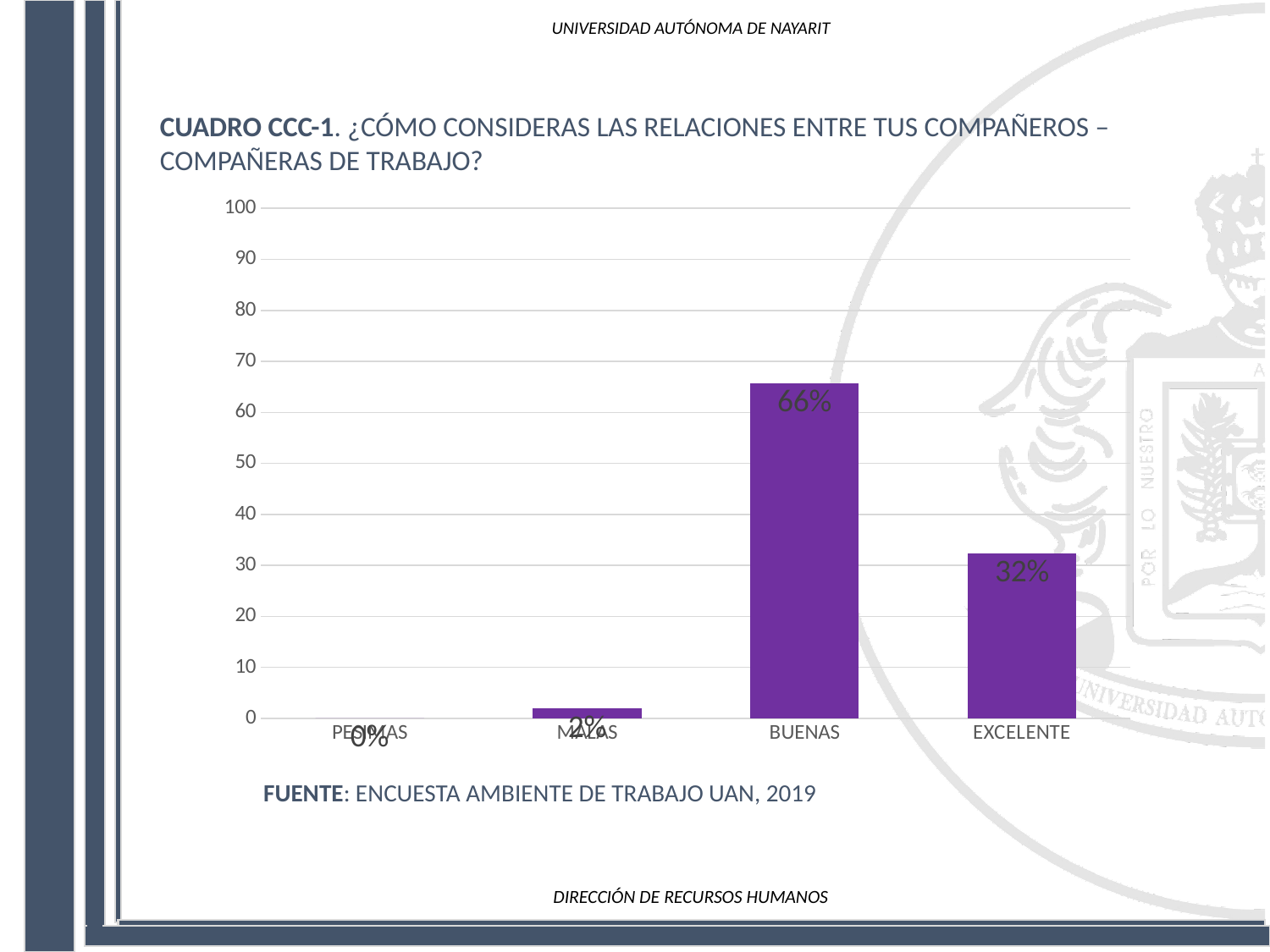
What is the value for PÉSIMAS? 0% What kind of chart is shown on the slide? bar chart What is the value for BUENAS? 66% What is the difference between the values for BUENAS and EXCELENTE? 34% Which category has the lowest value? PÉSIMAS Which category has the highest value? BUENAS Is the value for BUENAS greater or less than 60? greater Which is larger, the value for EXCELENTE or the value for MALAS? EXCELENTE What is the value for EXCELENTE? 32% What is the value for MALAS? 2% What source is cited below the chart? ENCUESTA AMBIENTE DE TRABAJO UAN, 2019 How many categories are shown on the x axis? 4